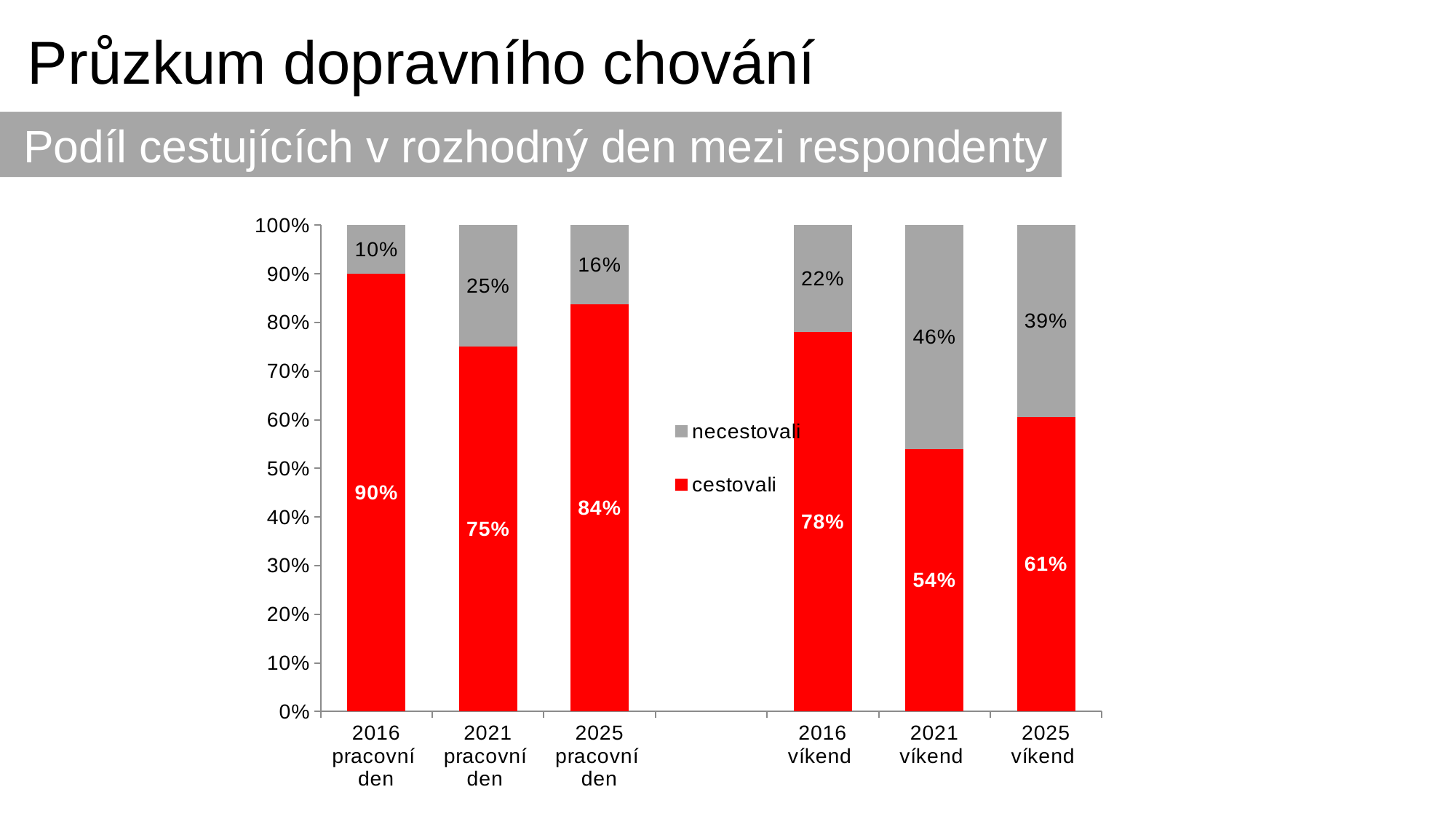
What is the value of 'cestovali' for '2025 víkend'? 61% What kind of chart is shown on the slide? stacked bar chart Which category has the highest 'cestovali' value? 2016 pracovní den Which category has the lowest 'cestovali' value? 2021 víkend What is the value of 'necestovali' for '2021 víkend'? 46% How many series does the legend list? 2 What is the value of 'necestovali' for '2025 pracovní den'? 16% What is the difference between the 'cestovali' values for '2016 pracovní den' and '2021 pracovní den'? 15% What is the total of the stacked bar for '2021 pracovní den'? 100% Which is larger: the 'necestovali' value for '2016 víkend' or for '2025 víkend'? 2025 víkend What is the value of 'cestovali' for '2016 pracovní den'? 90% How many categories are shown on the x axis? 6